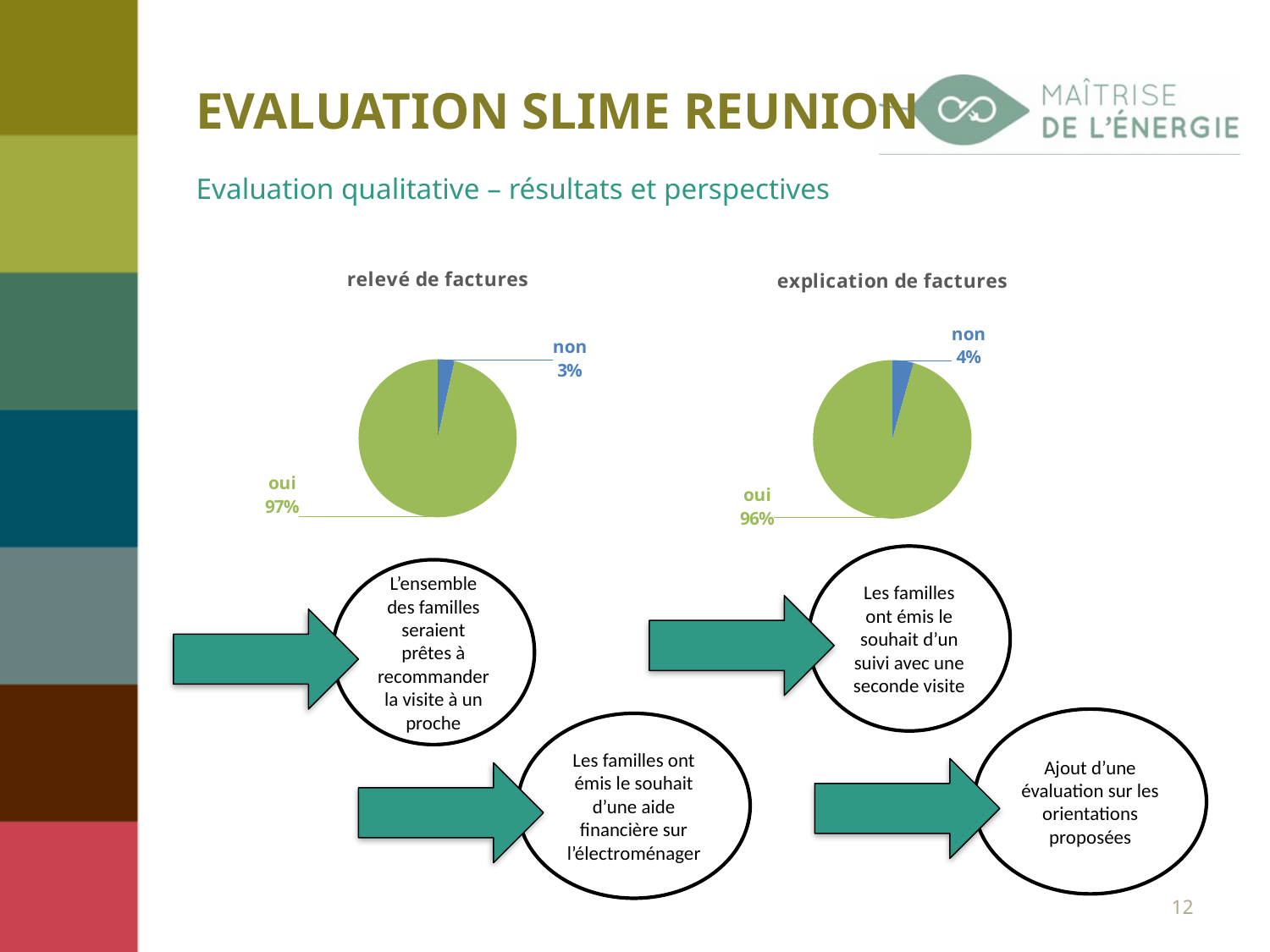
In the 'relevé de factures' chart, which category has the largest slice? oui In the 'relevé de factures' chart, what is the difference between the 'oui' and 'non' percentages? 94% What type of chart is the 'explication de factures' chart? pie chart How many slices does the 'relevé de factures' pie chart have? 2 Which chart has the larger 'non' share, 'relevé de factures' or 'explication de factures'? explication de factures In the 'explication de factures' chart, what percentage is shown for 'oui'? 96% In the 'relevé de factures' chart, what percentage is shown for 'non'? 3% In the 'explication de factures' chart, which category has the smallest slice? non In the 'explication de factures' chart, what percentage is shown for 'non'? 4% In the 'relevé de factures' chart, what percentage is shown for 'oui'? 97% What is the title of the chart on the left side of the slide? relevé de factures In the 'explication de factures' chart, what is the difference between the 'oui' and 'non' percentages? 92%